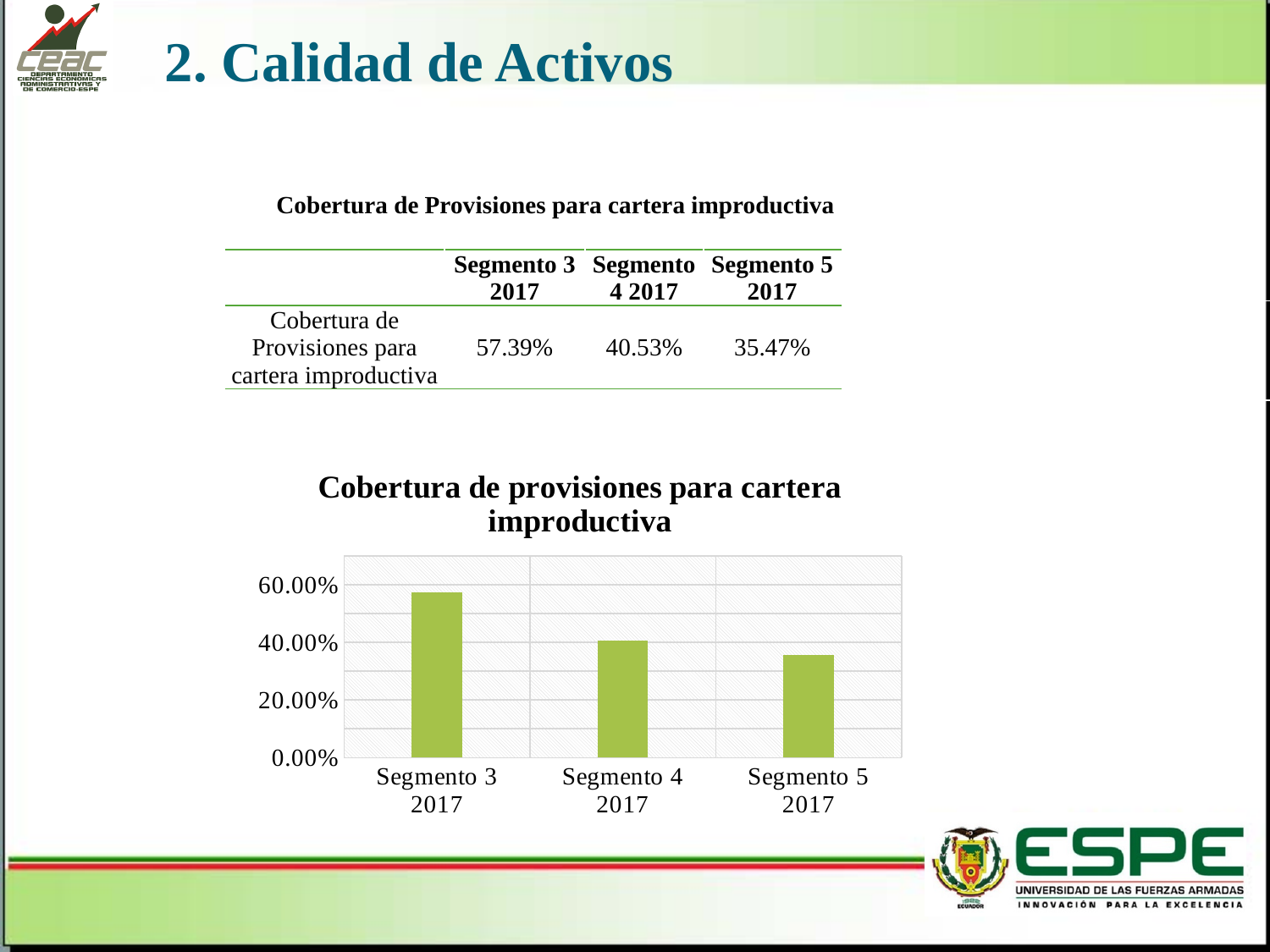
How many categories are plotted in the chart? 3 Is the value for Segmento 3 2017 greater or less than 40.00%? greater According to the table on the slide, what is the value for Segmento 4 2017? 40.53% Which is larger, the value for Segmento 4 2017 or Segmento 5 2017? Segmento 4 2017 According to the table on the slide, what is the value for Segmento 3 2017? 57.39% What type of chart is shown on the slide? bar chart Is the value for Segmento 5 2017 greater or less than 40.00%? less Do the values rise or fall from Segmento 3 2017 to Segmento 5 2017? fall Which segment has the lowest coverage of provisions for non-performing portfolio? Segmento 5 2017 According to the table on the slide, what is the value for Segmento 5 2017? 35.47% Which segment has the highest coverage of provisions for non-performing portfolio? Segmento 3 2017 What is the title of the chart? Cobertura de provisiones para cartera improductiva